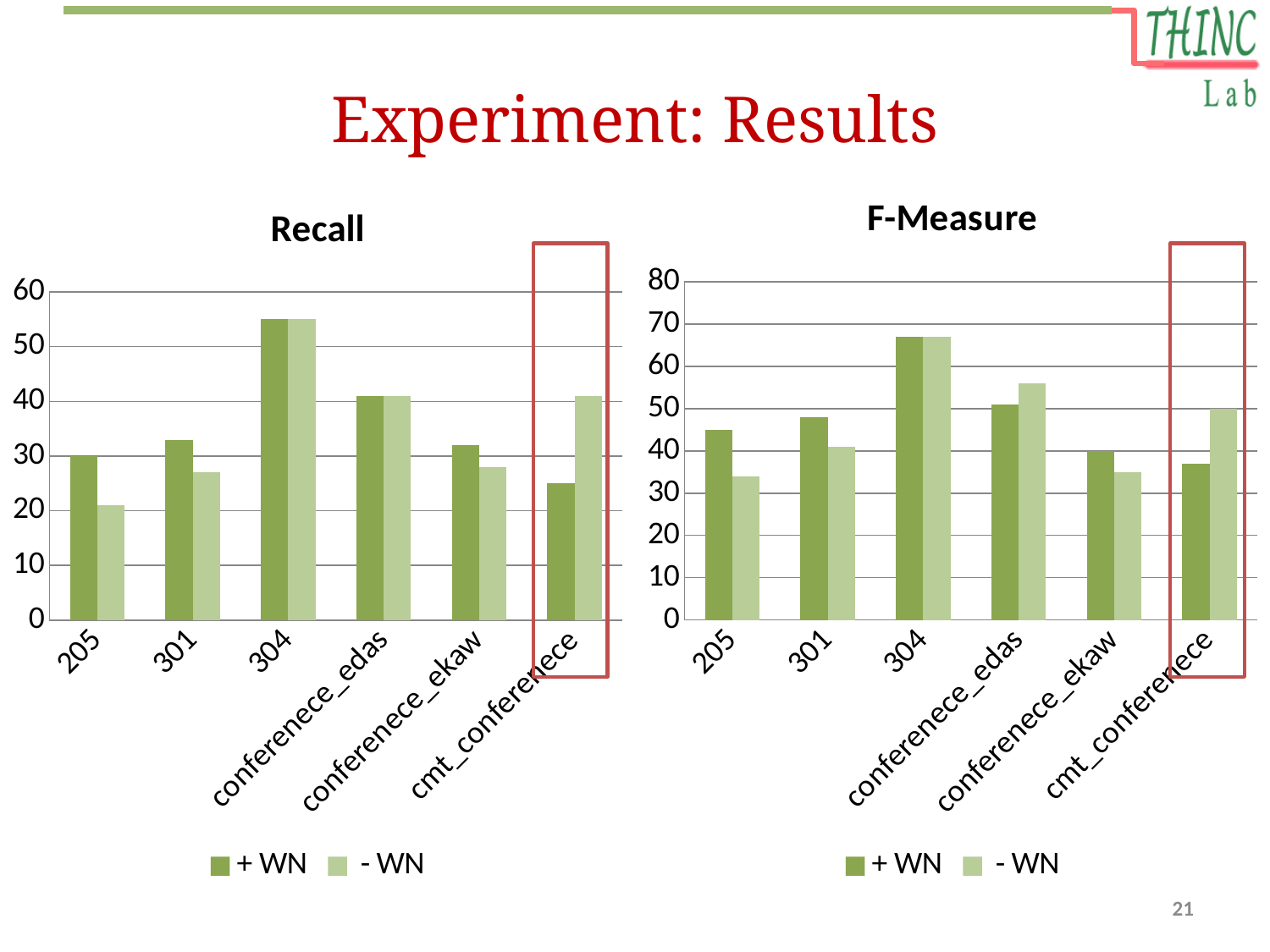
In the F-Measure chart, which category has the highest - WN value? 304 In the F-Measure chart, for conferenece_edas, which is larger: + WN or - WN? - WN In the Recall chart, for cmt_conferenece, which is larger: + WN or - WN? - WN What kind of chart is the Recall chart? bar chart In the Recall chart, is the + WN value for 304 greater or less than 50? greater In the Recall chart, which category has the lowest - WN value? 205 How many series does the legend of the F-Measure chart list? 2 In the F-Measure chart, is the + WN value for cmt_conferenece greater or less than 40? less In the F-Measure chart, is the - WN value for 205 greater or less than 40? less In the Recall chart, which category has the highest + WN value? 304 How many categories are shown on the x axis of the Recall chart? 6 What are the two legend entries in the Recall chart? + WN and - WN